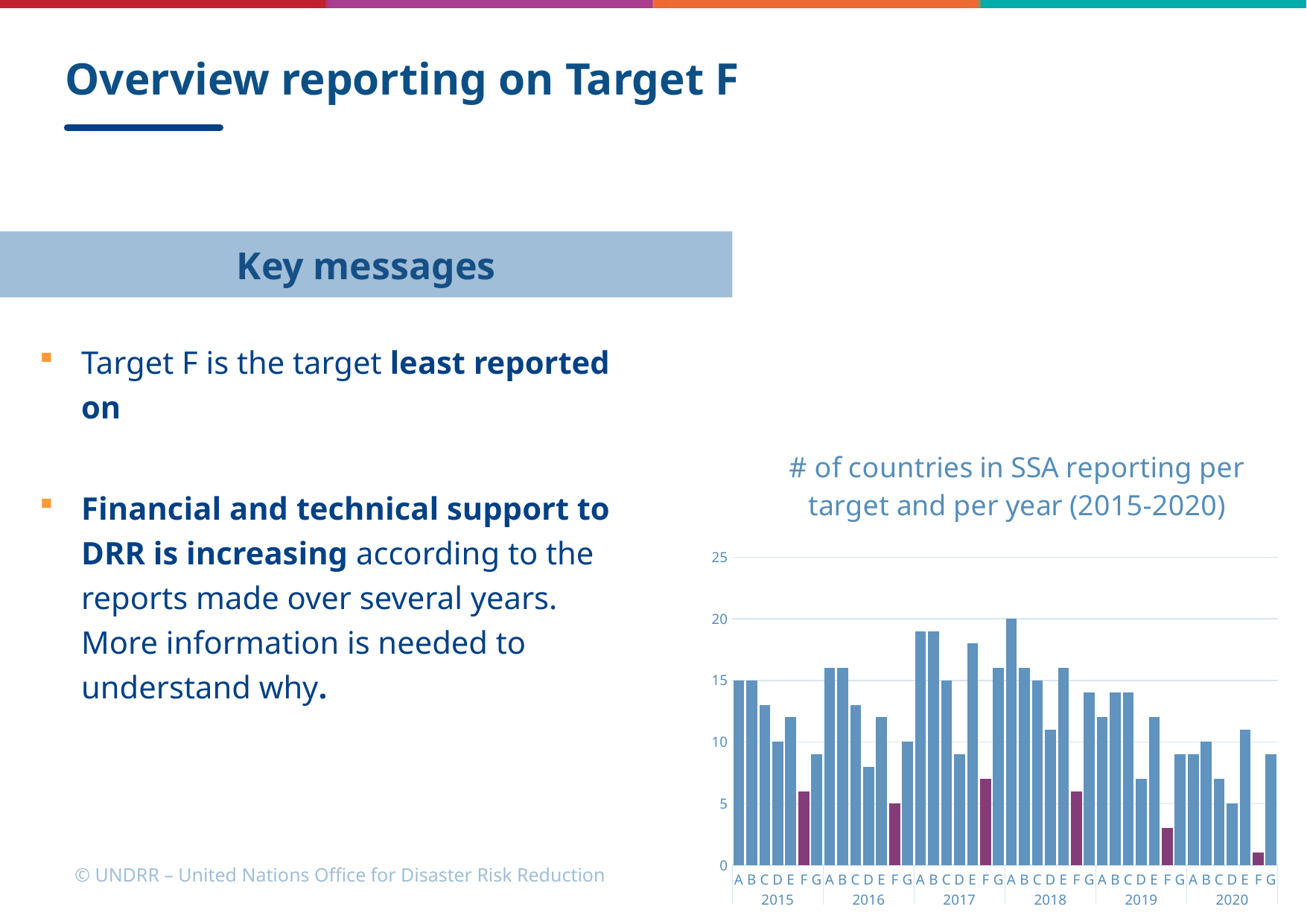
What type of chart is shown on the slide? bar chart Is the value for target F in 2019 greater or less than 5? less How many target bars (A to G) are shown for each year in the chart? 7 Is the value for target E in 2017 greater or less than 15? greater Which is larger in the chart: target A in 2017 or target D in 2017? target A in 2017 What is the title of the chart? # of countries in SSA reporting per target and per year (2015-2020) How many years are shown along the x axis of the chart? 6 Is the value for target A in 2017 greater or less than 15? greater Which bar in the chart is the highest overall? A in 2018 Which bar in the chart is the lowest overall? F in 2020 Which target's bars are coloured purple in the chart? F